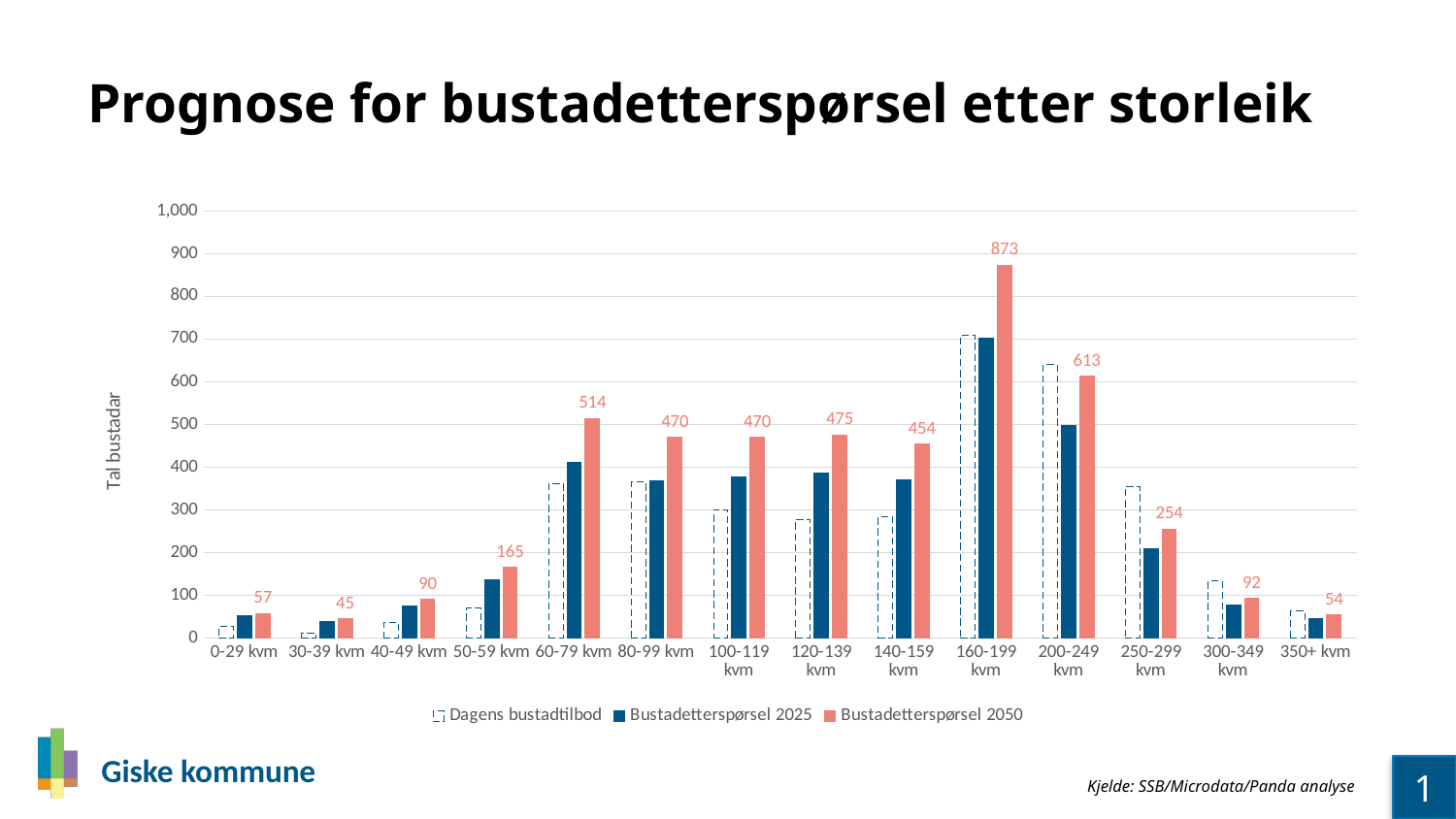
What is the value for Bustadetterspørsel 2050 in the 30-39 kvm category? 45 What is the value for Bustadetterspørsel 2050 in the 60-79 kvm category? 514 Which category has the highest value for Bustadetterspørsel 2050? 160-199 kvm What is the value for Bustadetterspørsel 2050 in the 160-199 kvm category? 873 What is the difference between the Bustadetterspørsel 2050 values for 160-199 kvm and 200-249 kvm? 260 How many size categories are shown on the x axis? 14 Which is larger for Bustadetterspørsel 2050: 250-299 kvm or 50-59 kvm? 250-299 kvm Which category has the lowest value for Bustadetterspørsel 2050? 30-39 kvm Is the value for Dagens bustadtilbod in the 120-139 kvm category greater or less than 300? less How many series does the legend list? 3 Is the value for Bustadetterspørsel 2025 in the 160-199 kvm category greater or less than 600? greater What kind of chart is shown on the slide? Bar chart